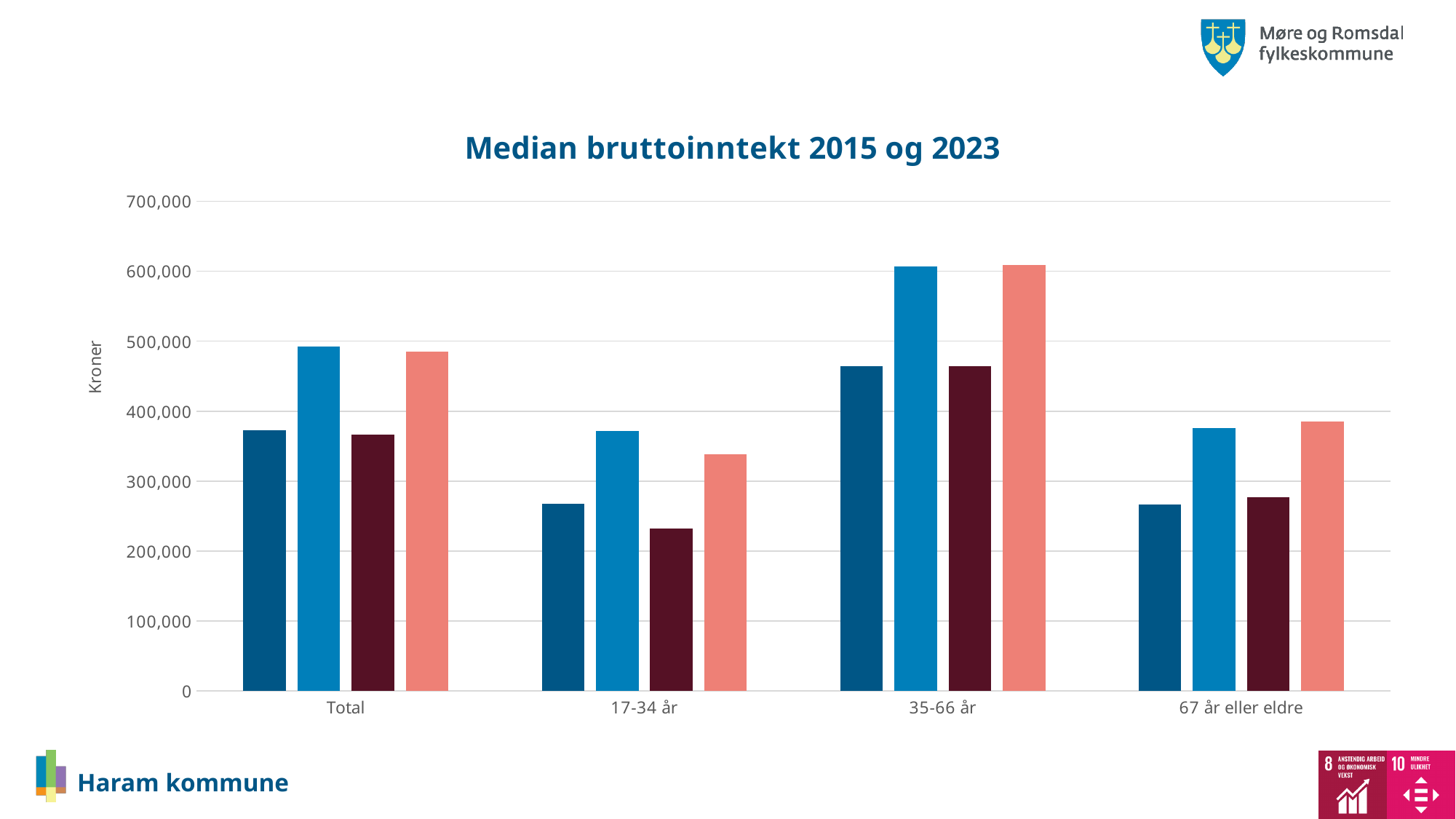
Which category has the tallest bars on the chart? 35-66 år What is the title of the chart? Median bruttoinntekt 2015 og 2023 Is the dark red bar for 17-34 år greater or less than 300,000? less How many bars are plotted for each category on the chart? 4 What kind of chart is shown on the slide? bar chart What is the label on the vertical axis of the chart? Kroner Is the light blue bar for 35-66 år greater or less than 600,000? greater Which is larger: the light blue bar for Total or the light blue bar for 17-34 år? Total Is the dark blue bar for Total greater or less than 300,000? greater Which category has the lowest dark red bar on the chart? 17-34 år How many categories are shown along the x axis of the chart? 4